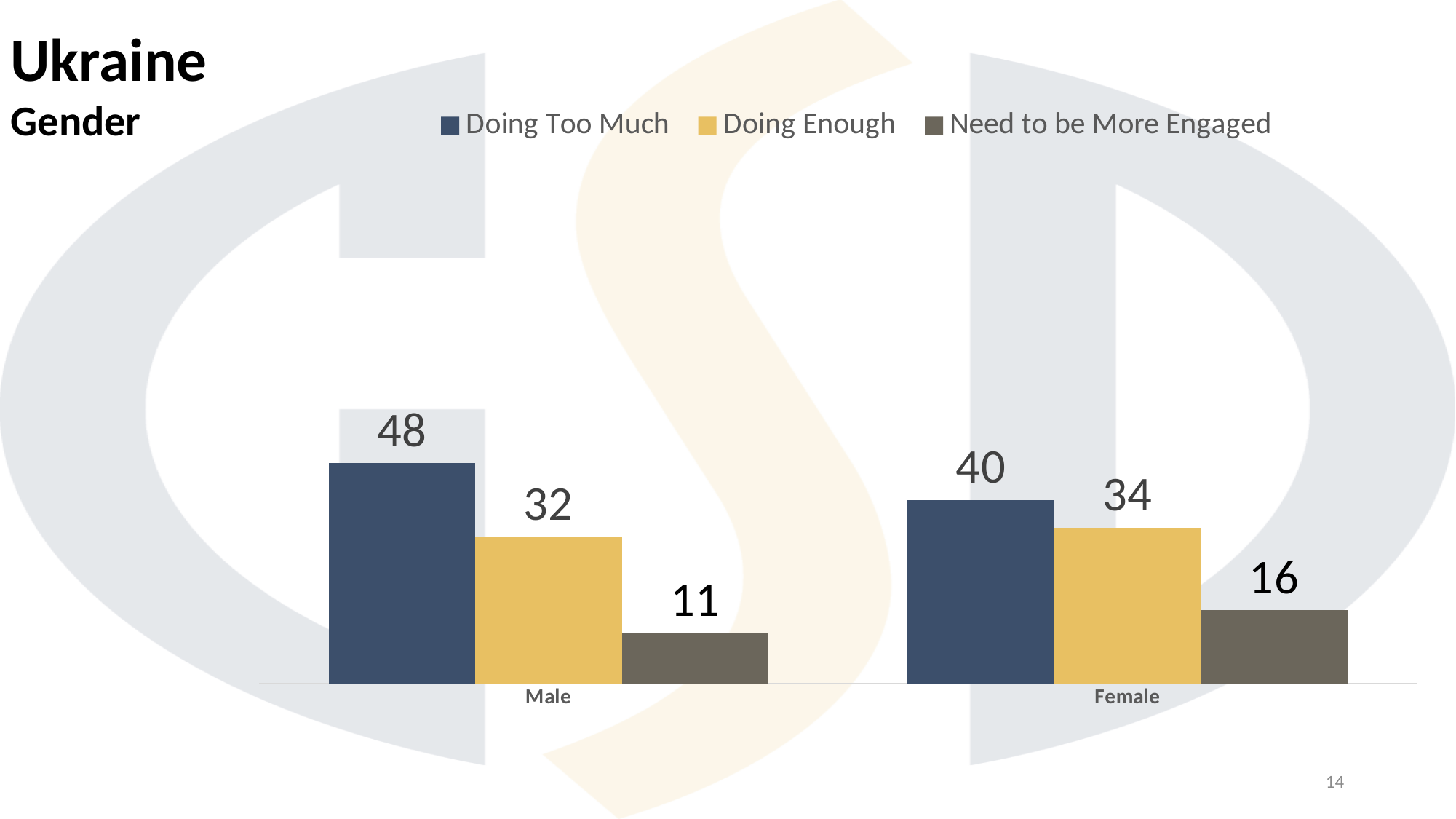
What is the difference between the "Doing Too Much" values for Male and Female respondents? 8 What kind of chart is shown on the slide? Bar chart Which is larger: "Doing Enough" for Male or "Doing Enough" for Female? Female How many series does the legend list? 3 What is the value for "Doing Enough" among Female respondents? 34 What is the difference between "Doing Enough" and "Need to be More Engaged" for Female respondents? 18 What is the value for "Doing Too Much" among Male respondents? 48 How many categories are shown on the x axis? 2 Which series has the highest value for Male respondents? Doing Too Much What is the value for "Doing Too Much" among Female respondents? 40 What is the value for "Need to be More Engaged" among Male respondents? 11 Which series has the lowest value for Female respondents? Need to be More Engaged